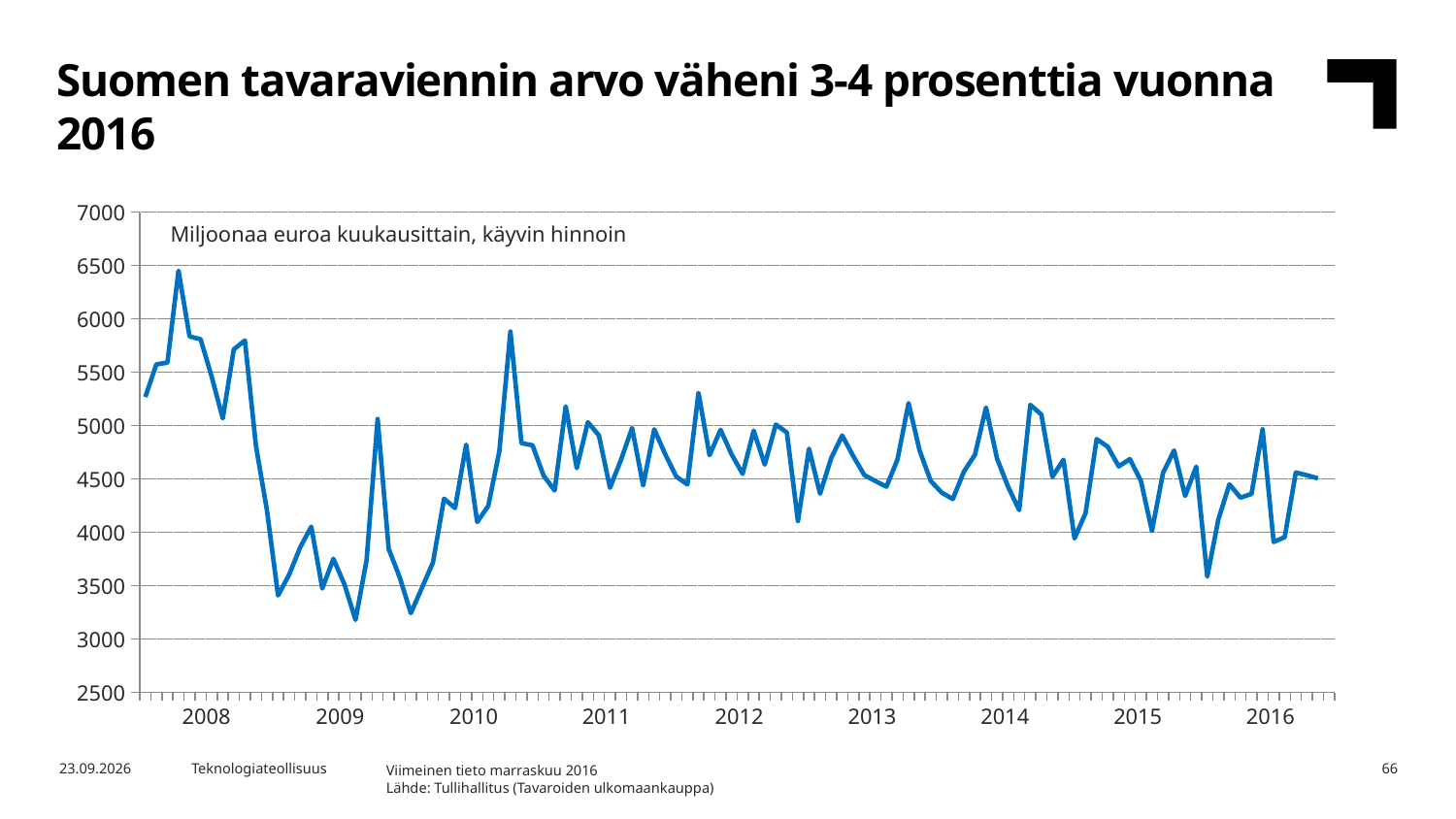
What kind of chart is shown on the slide? line chart How many years are labelled on the x axis? 9 Is the last plotted value at the end of the line in 2016 greater or less than 5000? less What text is written inside the chart area describing the unit of the values? Miljoonaa euroa kuukausittain, käyvin hinnoin According to the note below the chart, what is the source of the data? Tullihallitus (Tavaroiden ulkomaankauppa) Is the peak value plotted in 2010 greater or less than 5500? greater Is the lowest value plotted in 2009 greater or less than 3500? less In which year does the line reach its lowest value? 2009 In which year does the line reach its highest value? 2008 Does the line rise or fall from its peak in 2008 to the start of 2009? fall